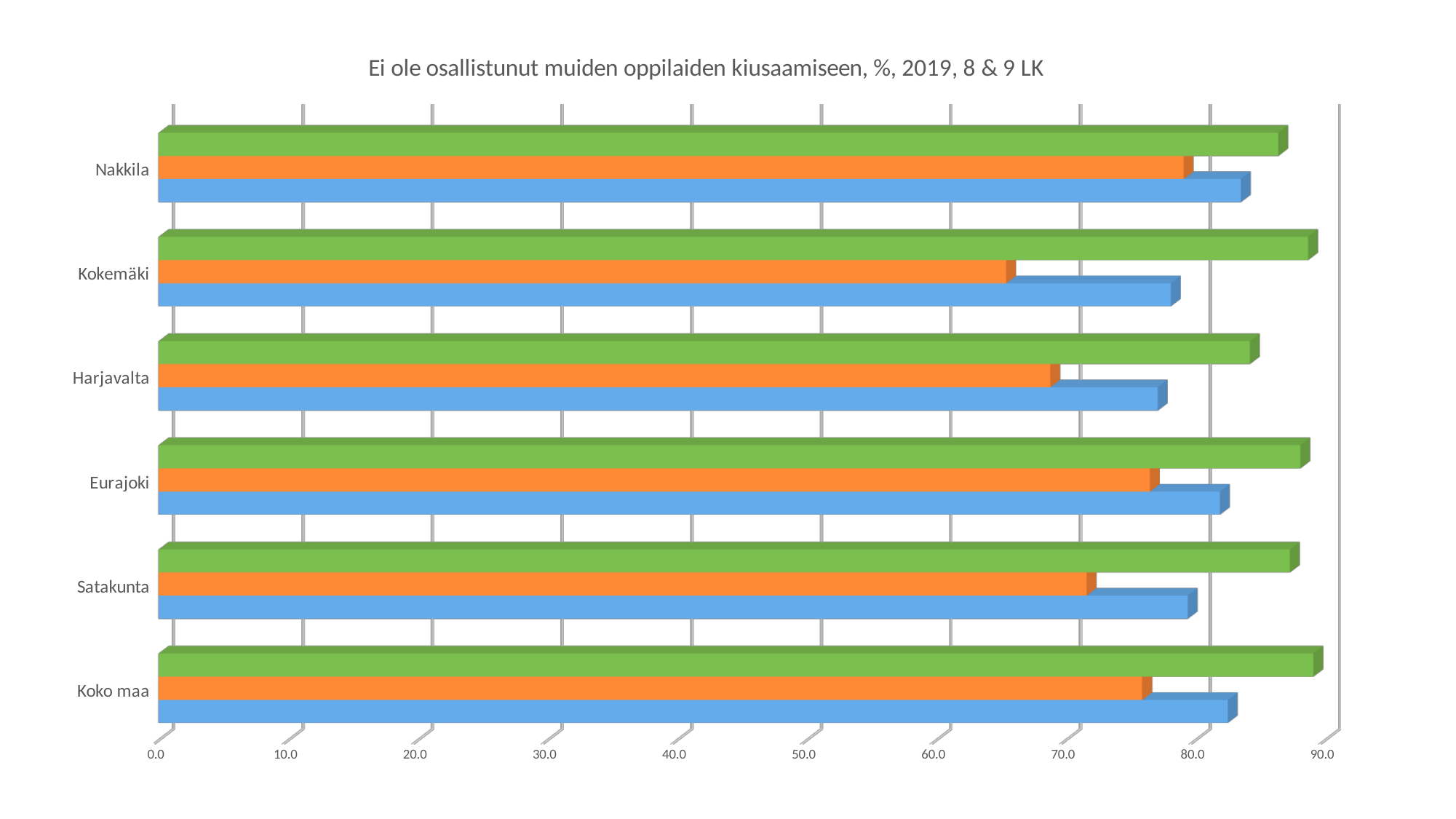
Is the value of the blue bar for Harjavalta greater or less than 80? less How many categories are shown on the vertical axis of the chart? 6 Is the value of the orange bar for Satakunta greater or less than 60? greater Which category has the highest value for the orange bar? Nakkila What is the title of the chart? Ei ole osallistunut muiden oppilaiden kiusaamiseen, %, 2019, 8 & 9 LK For Kokemäki, which is larger: the green bar or the orange bar? the green bar Is the value of the orange bar for Kokemäki greater or less than 70? less Which category has the lowest value for the orange bar? Kokemäki How many bars are shown for each category in the chart? 3 What is the highest value shown on the horizontal axis of the chart? 90.0 What kind of chart is shown on the slide? bar chart